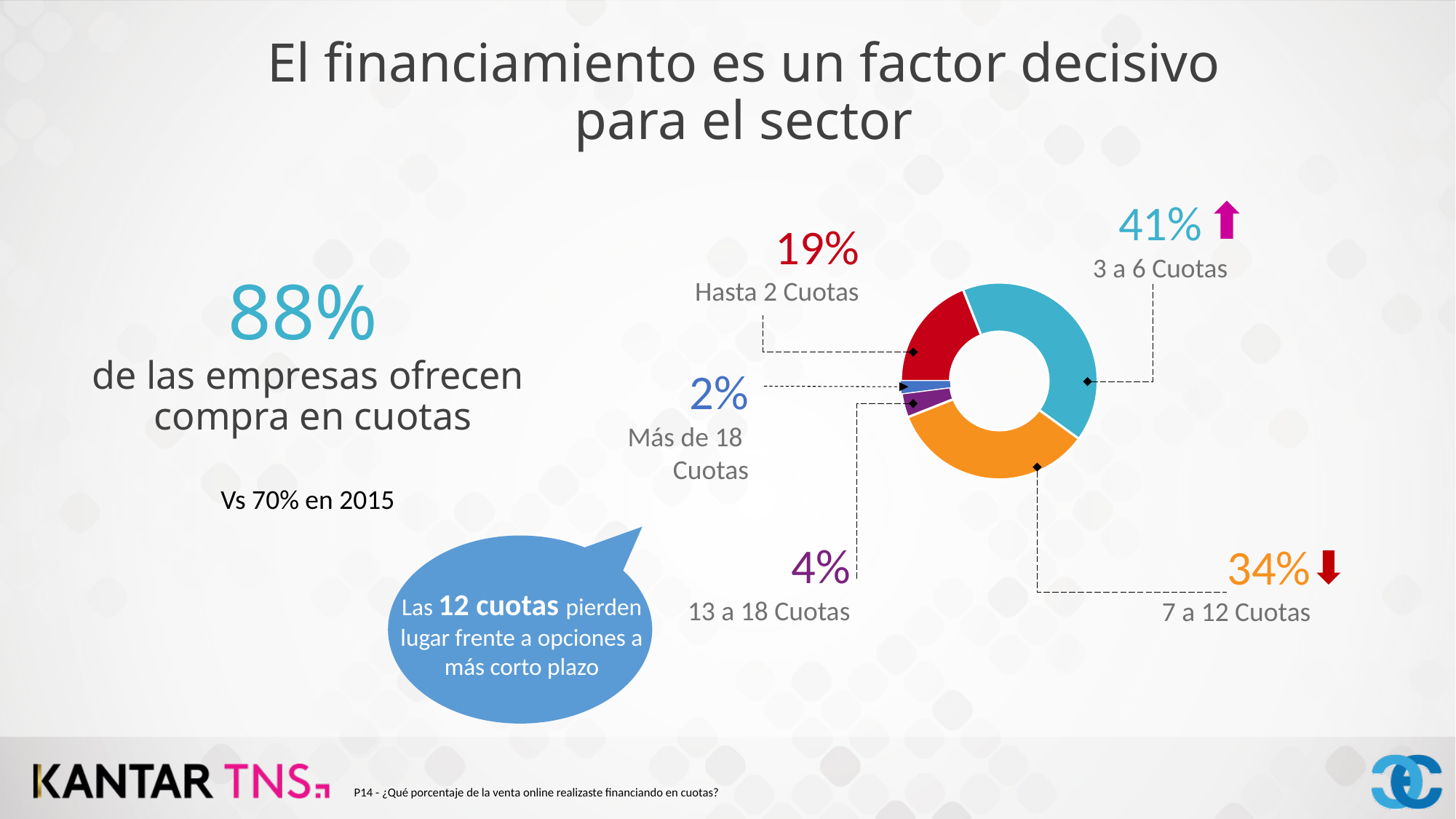
What is the difference between the shares for '3 a 6 Cuotas' and '7 a 12 Cuotas'? 7% What value is shown for '13 a 18 Cuotas' in the donut chart? 4% Which category has the smallest share in the donut chart? Más de 18 Cuotas What colour is the '7 a 12 Cuotas' slice in the donut chart? Orange Which category has the largest share in the donut chart? 3 a 6 Cuotas What kind of chart is shown on the slide? Donut (pie) chart Which is larger in the donut chart: 'Hasta 2 Cuotas' or '13 a 18 Cuotas'? Hasta 2 Cuotas What value is shown for 'Más de 18 Cuotas' in the donut chart? 2% What value is shown for '7 a 12 Cuotas' in the donut chart? 34% How many categories does the donut chart show? 5 What value is shown for 'Hasta 2 Cuotas' in the donut chart? 19% What share of the donut chart is labelled '3 a 6 Cuotas'? 41%